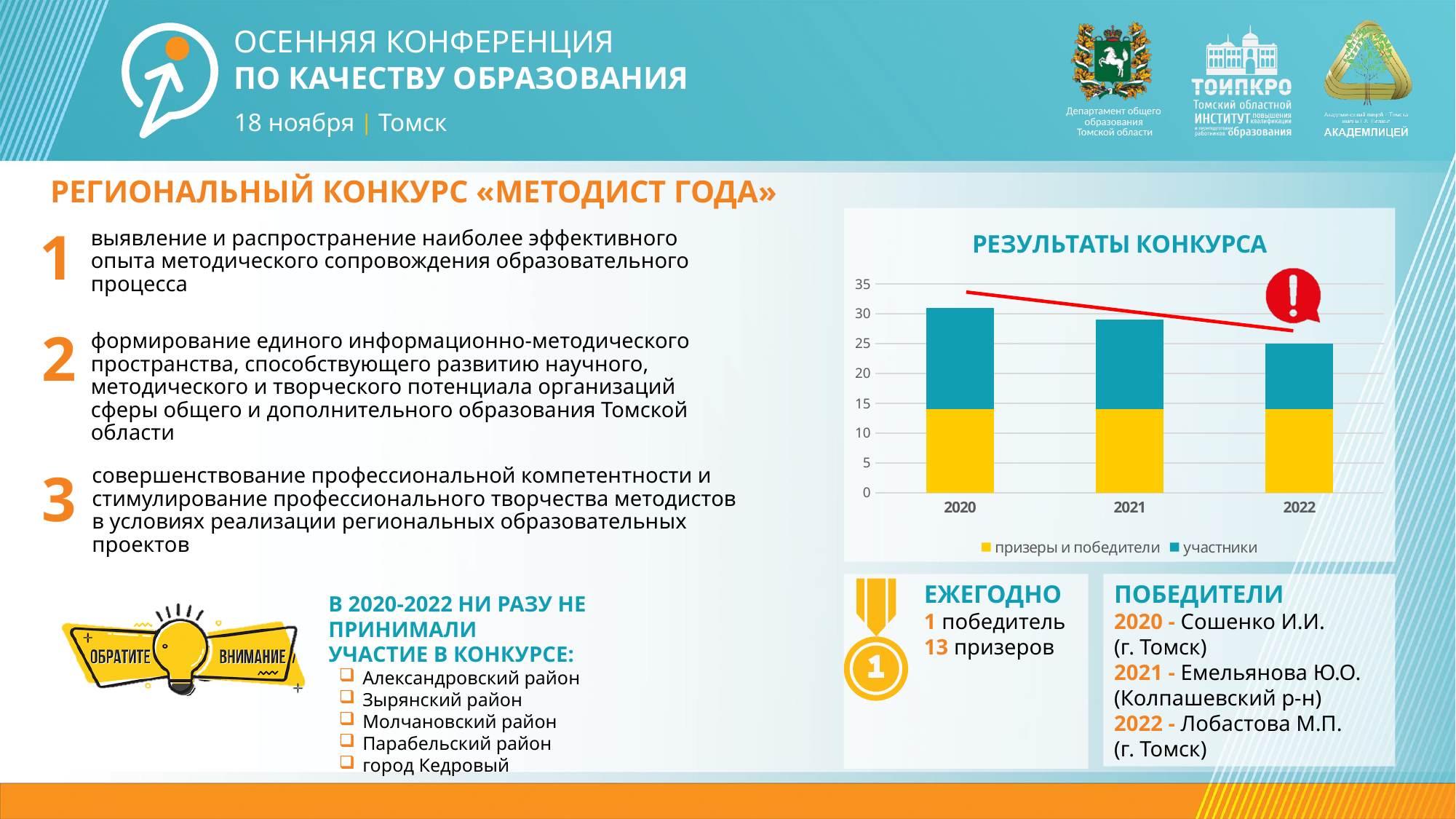
Is the «призеры и победители» segment for 2020 greater or less than 10? greater What kind of chart is shown under the title «РЕЗУЛЬТАТЫ КОНКУРСА»? Stacked bar chart What is the title of the chart on the slide? РЕЗУЛЬТАТЫ КОНКУРСА Do the total bar heights rise or fall from 2020 to 2022? Fall Is the total bar for 2021 greater or less than 20? greater How many years (categories) are shown on the x axis of the chart? 3 Which year has the tallest total bar in the chart? 2020 How many series does the chart legend list? 2 Is the total bar for 2022 greater or less than 30? less Which year has the shortest total bar in the chart? 2022 Which series is shown in yellow in the chart? призеры и победители